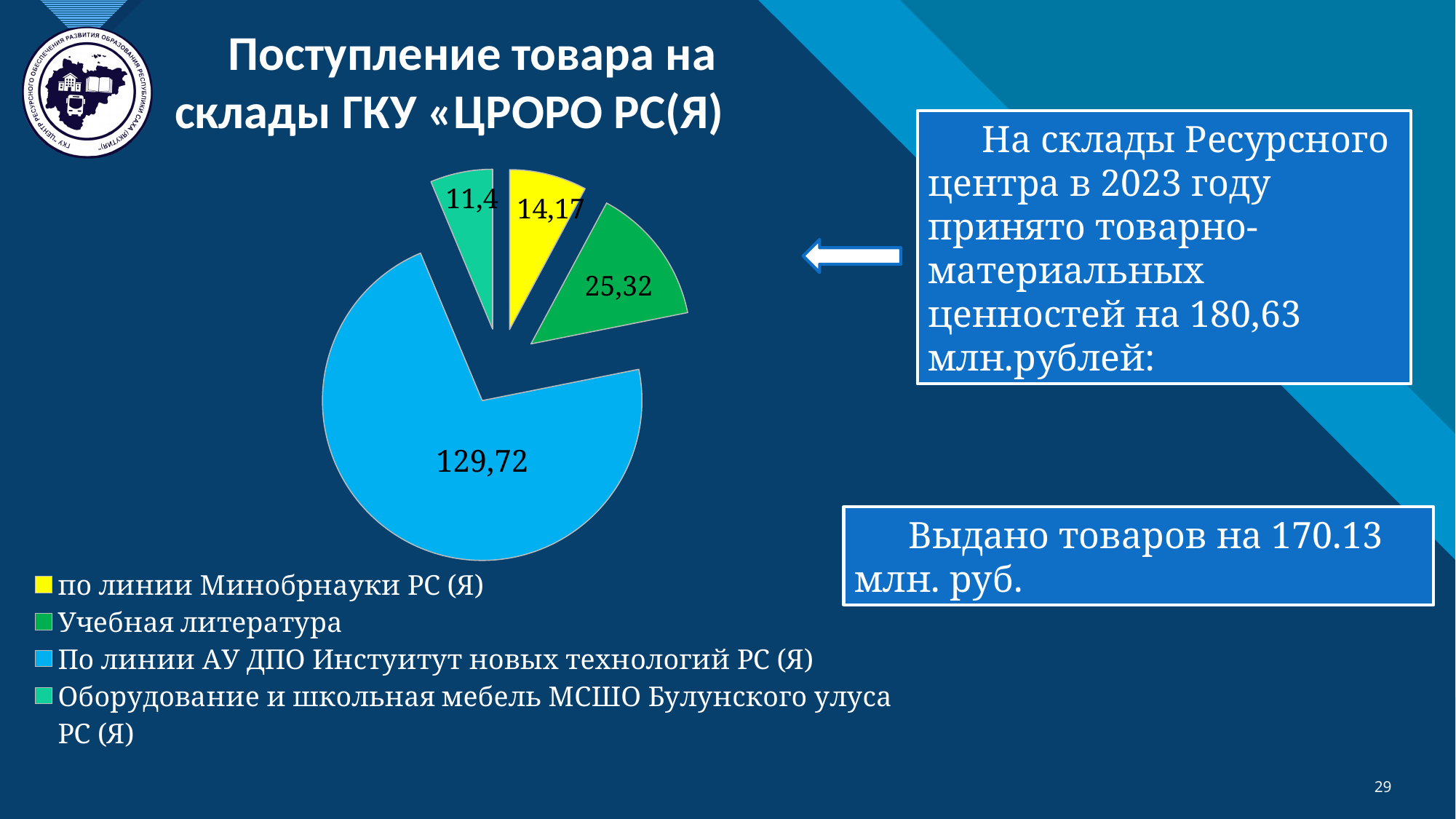
What is the value for the slice 'по линии Минобрнауки РС (Я)'? 14,17 What is the value for the slice 'По линии АУ ДПО Инстуитут новых технологий РС (Я)'? 129,72 What colour is the slice for 'Учебная литература'? Green What is the difference between the values for 'Учебная литература' and 'по линии Минобрнауки РС (Я)'? 11,15 Which category has the smallest slice in the pie chart? Оборудование и школьная мебель МСШО Булунского улуса РС (Я) How many slices does the pie chart have? 4 Which category has the largest slice in the pie chart? По линии АУ ДПО Инстуитут новых технологий РС (Я) What is the difference between the values for 'По линии АУ ДПО Инстуитут новых технологий РС (Я)' and 'Учебная литература'? 104,4 What is the value for the slice 'Учебная литература'? 25,32 Which is larger: the value for 'по линии Минобрнауки РС (Я)' or for 'Оборудование и школьная мебель МСШО Булунского улуса РС (Я)'? по линии Минобрнауки РС (Я) What is the value for the slice 'Оборудование и школьная мебель МСШО Булунского улуса РС (Я)'? 11,4 What type of chart is shown on the slide? Pie chart